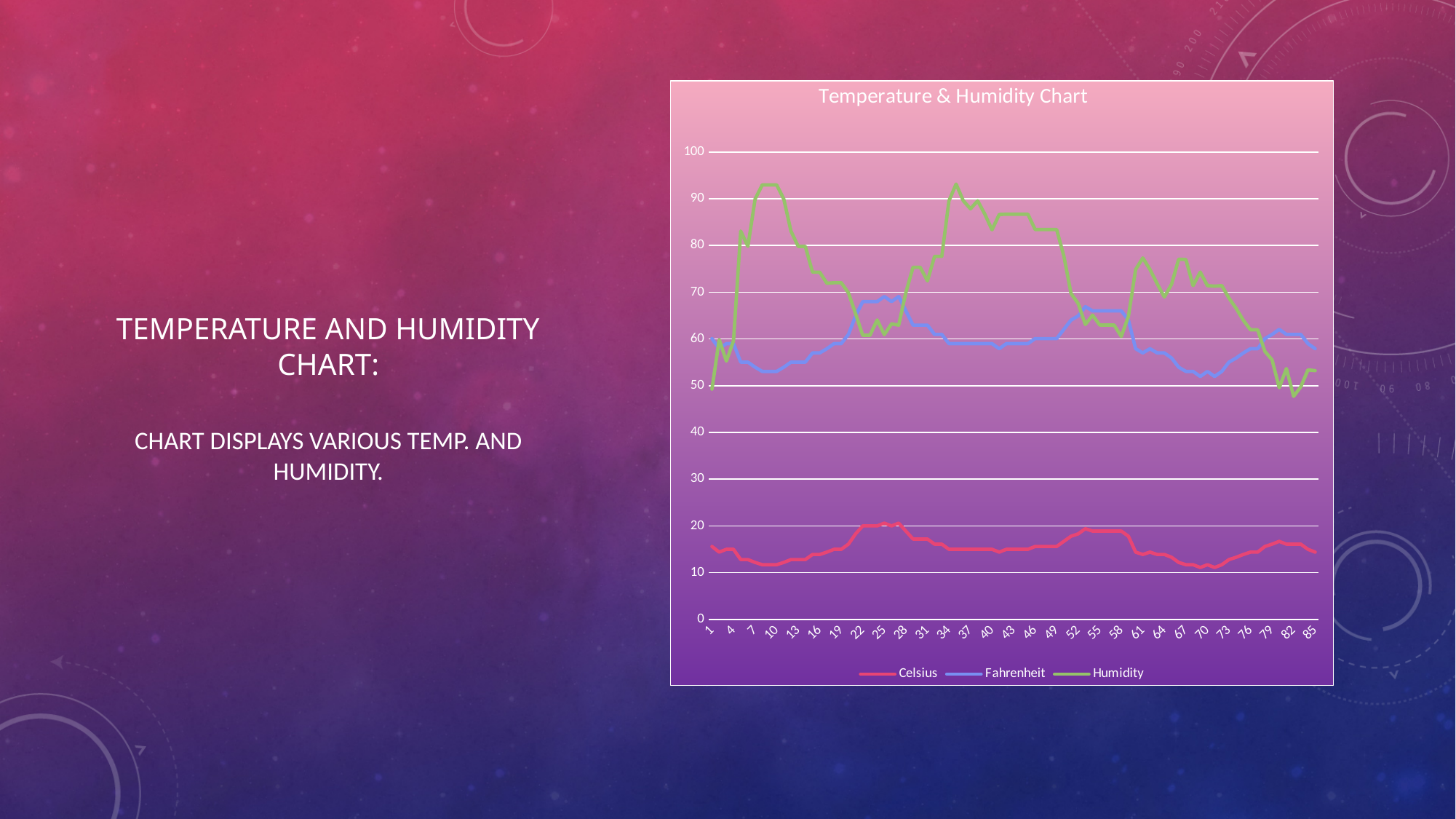
Is the Humidity value at point 40 greater or less than 80? greater Which series in the chart is drawn in green? Humidity At point 10, which is larger: the Humidity value or the Fahrenheit value? Humidity Is the Celsius value at point 1 greater or less than 20? less What kind of chart is shown on the slide? line chart Which series reaches the highest value anywhere on the chart? Humidity How many series does the legend of the Temperature & Humidity Chart list? 3 Is the Humidity value at point 10 greater or less than 90? greater Which series stays lowest across the whole chart? Celsius What is the title of the chart on the slide? Temperature & Humidity Chart